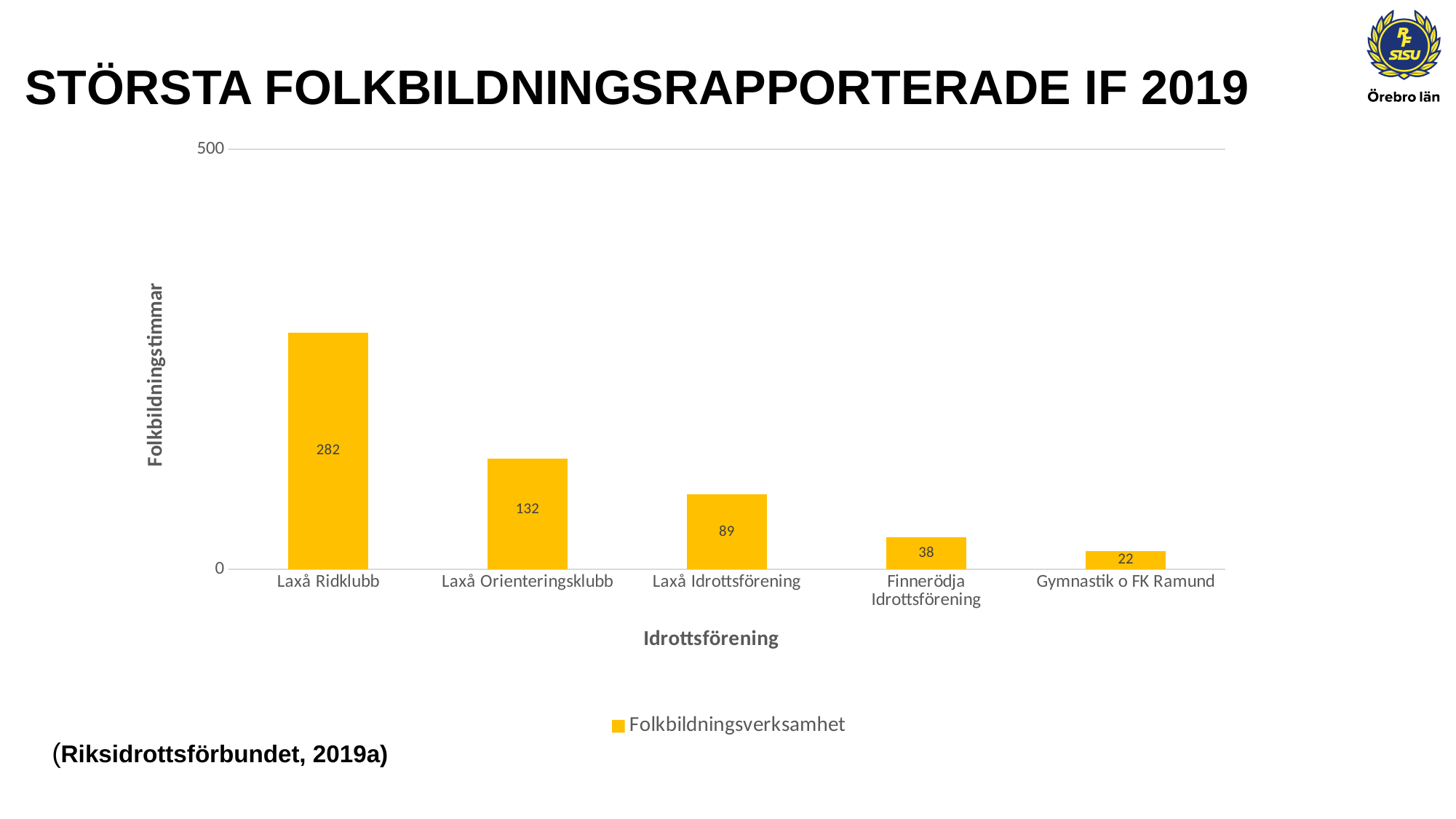
What is the value for Laxå Orienteringsklubb? 132 Which is larger, the value for Laxå Idrottsförening or Finnerödja Idrottsförening? Laxå Idrottsförening What is the value for Gymnastik o FK Ramund? 22 What is the value for Laxå Ridklubb? 282 What is the difference between the values for Laxå Ridklubb and Laxå Orienteringsklubb? 150 What is the value for Finnerödja Idrottsförening? 38 How many categories are shown on the x axis? 5 What kind of chart is shown on the slide? bar chart Is the value for Laxå Ridklubb greater or less than 500? less Which category has the highest value? Laxå Ridklubb Which category has the lowest value? Gymnastik o FK Ramund What is the series name shown in the legend? Folkbildningsverksamhet